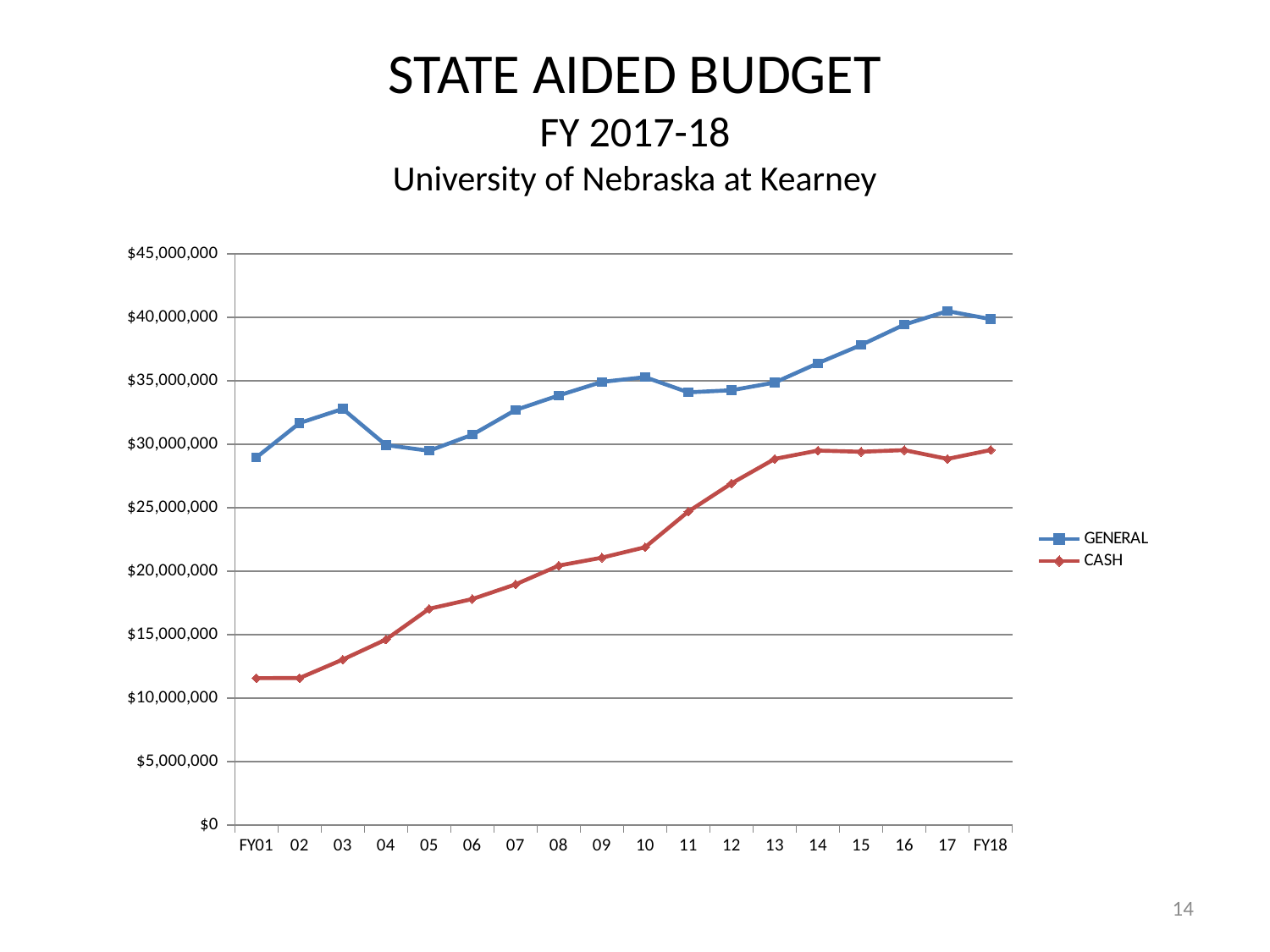
Is the CASH value for fiscal year 10 greater or less than $25,000,000? less How many fiscal years are plotted along the x axis? 18 Which colour is used for the CASH series? red Is the GENERAL value for fiscal year 17 greater or less than $40,000,000? greater Is the GENERAL value for fiscal year 14 greater or less than $35,000,000? greater How many series does the legend list? 2 Does the CASH series generally rise or fall from FY01 to FY18? rise What kind of chart is shown on the slide? line chart In which fiscal year does the GENERAL series reach its highest value? 17 Which series has the larger value in FY18, GENERAL or CASH? GENERAL